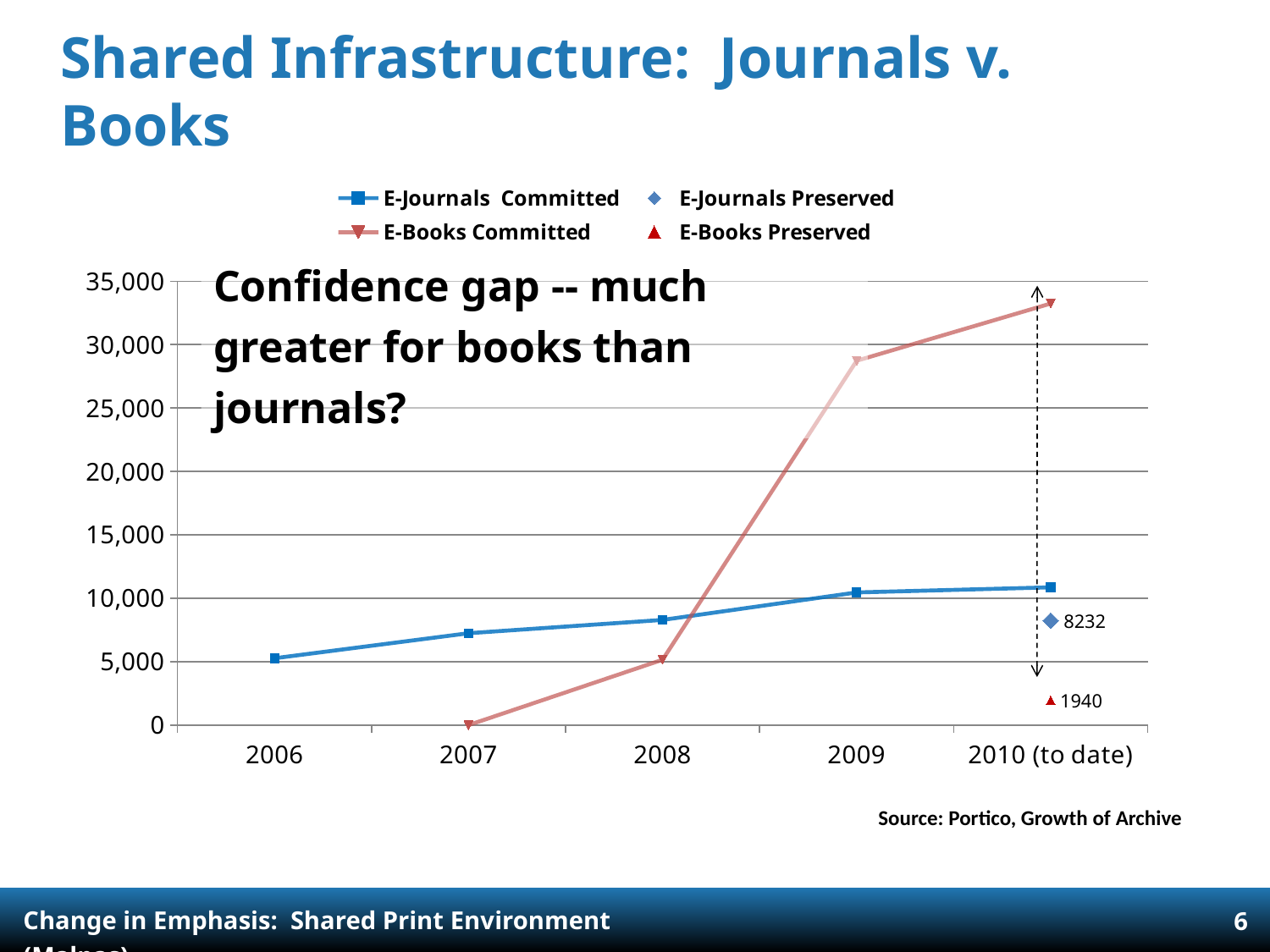
Which series has the highest value in 2010 (to date)? E-Books Committed What kind of chart is shown on the slide? Line chart Is the value for E-Journals Committed in 2006 greater or less than 10,000? less Is the value for E-Books Committed in 2010 (to date) greater or less than 30,000? greater What is the value for E-Books Preserved in 2010 (to date)? 1940 What is the value for E-Journals Preserved in 2010 (to date)? 8232 Which is larger in 2010 (to date): E-Journals Preserved or E-Books Preserved? E-Journals Preserved How many years are shown on the x axis? 5 Is the value for E-Books Committed in 2009 greater or less than 25,000? greater What is the difference between E-Journals Preserved and E-Books Preserved in 2010 (to date)? 6292 How many series does the legend list? 4 Do the values for E-Books Committed rise or fall from 2007 to 2010 (to date)? rise